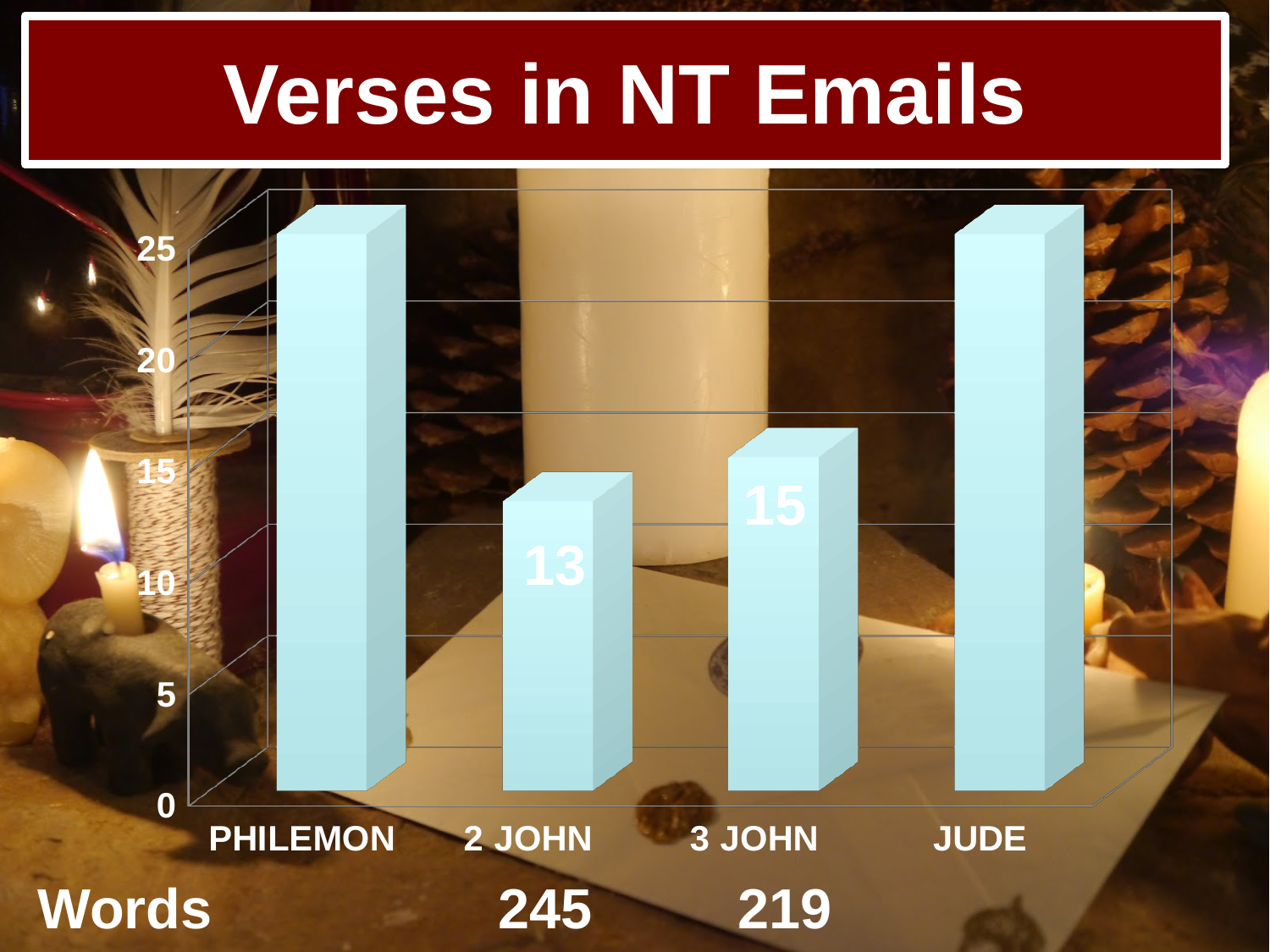
Is the value for PHILEMON greater or less than 20? greater Is the value for JUDE greater or less than 20? greater What is the label of the first category on the x axis? PHILEMON Which has a larger value, 2 JOHN or 3 JOHN? 3 JOHN What is the difference between the values for 3 JOHN and 2 JOHN? 2 What is the title of the chart? Verses in NT Emails How many categories are shown on the x axis? 4 Is the value for 2 JOHN greater or less than 15? less What kind of chart is shown on the slide? bar chart What is the value for 3 JOHN? 15 Which category has the lowest value? 2 JOHN What is the value for 2 JOHN? 13